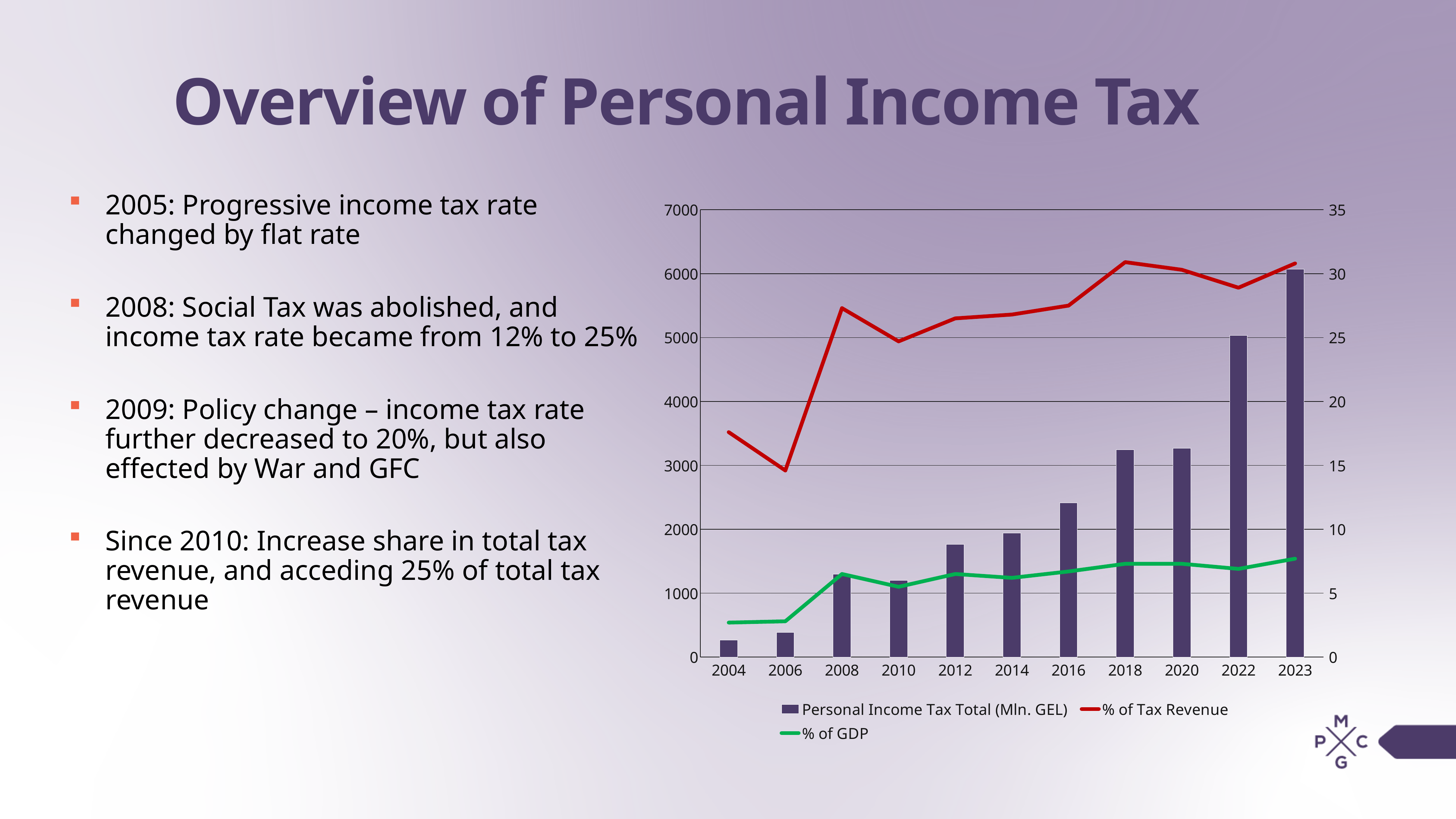
How many series does the chart legend list? 3 Is the Personal Income Tax Total (Mln. GEL) for 2016 greater or less than 2000? greater Which year has the highest Personal Income Tax Total (Mln. GEL) bar? 2023 How many years are shown on the x axis of the chart? 11 Which year has the lowest Personal Income Tax Total (Mln. GEL) bar? 2004 Is the % of Tax Revenue value for 2006 greater or less than 20? less Is the Personal Income Tax Total (Mln. GEL) for 2004 greater or less than 1000? less Which year has a larger Personal Income Tax Total (Mln. GEL) bar, 2012 or 2014? 2014 Do the Personal Income Tax Total (Mln. GEL) bars generally rise or fall from 2004 to 2023? rise In which year is the % of Tax Revenue line at its lowest point? 2006